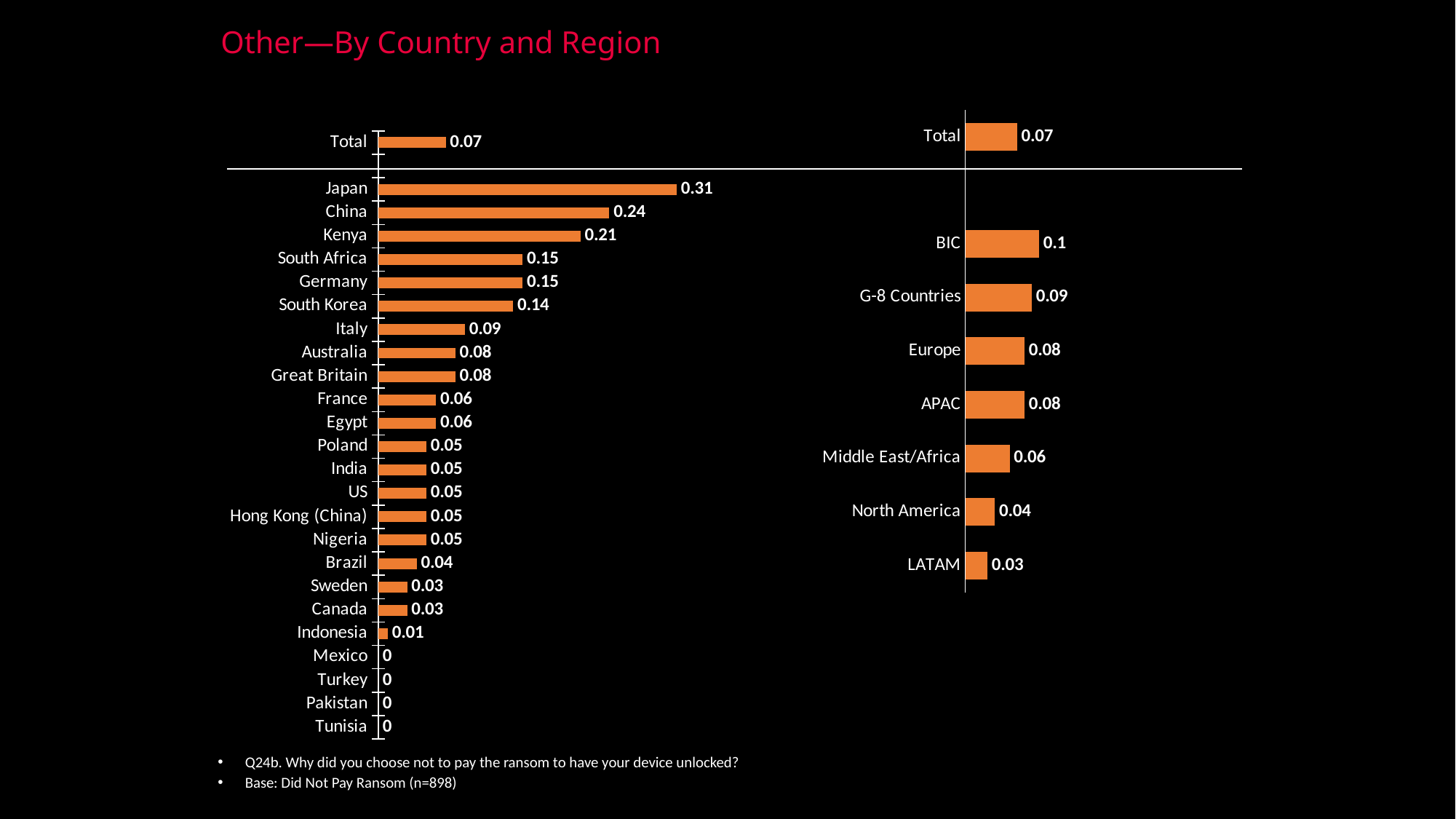
In the left chart (by country), which is larger, the value for Italy or the value for Brazil? Italy In the right chart (by region), what is the difference between the values for G-8 Countries and North America? 0.05 In the left chart (by country), which country has the highest value? Japan In the left chart (by country), what is the value for Indonesia? 0.01 In the right chart (by region), what is the value for BIC? 0.1 In the left chart (by country), what is the value for Japan? 0.31 In the left chart (by country), what is the difference between the values for China and South Korea? 0.1 What type of chart is used on this slide? Bar chart In the left chart (by country), what is the value for Kenya? 0.21 In the left chart (by country), how many countries are listed below the Total bar? 24 In the right chart (by region), how many regions are listed below the Total bar? 7 In the right chart (by region), which region has the lowest value? LATAM